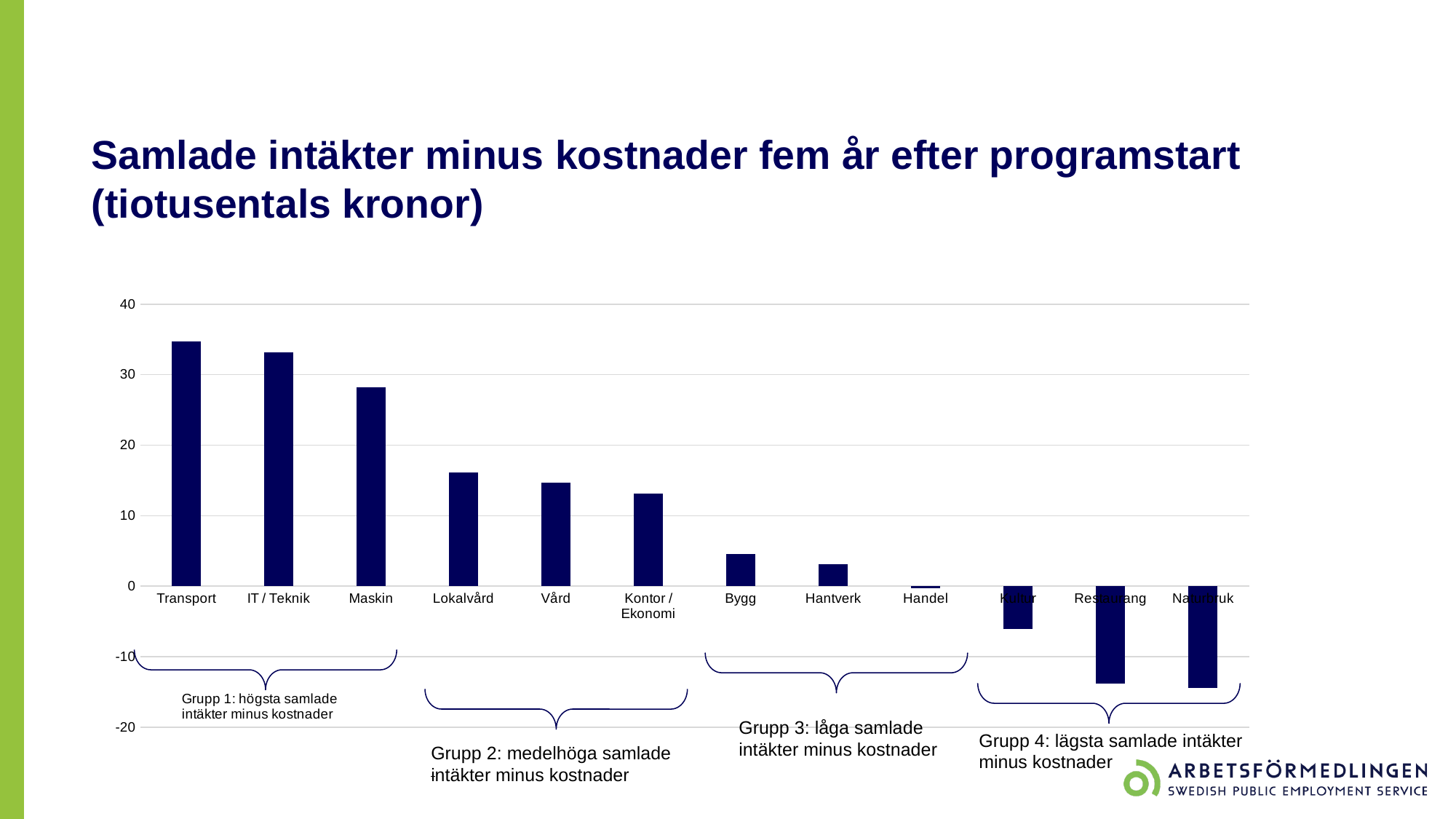
How many groups (Grupp) are marked with brackets below the chart? 4 Is the value for Lokalvård greater or less than 10? greater Which is larger, the value for Vård or the value for Hantverk? Vård Is the value for Maskin greater or less than 30? less Is the value for Transport greater or less than 30? greater Do the values generally rise or fall from left to right along the x axis? fall Which category has the highest value? Transport How many categories are plotted on the x axis? 12 Which is larger, the value for Transport or the value for Maskin? Transport What kind of chart is shown on the slide? bar chart